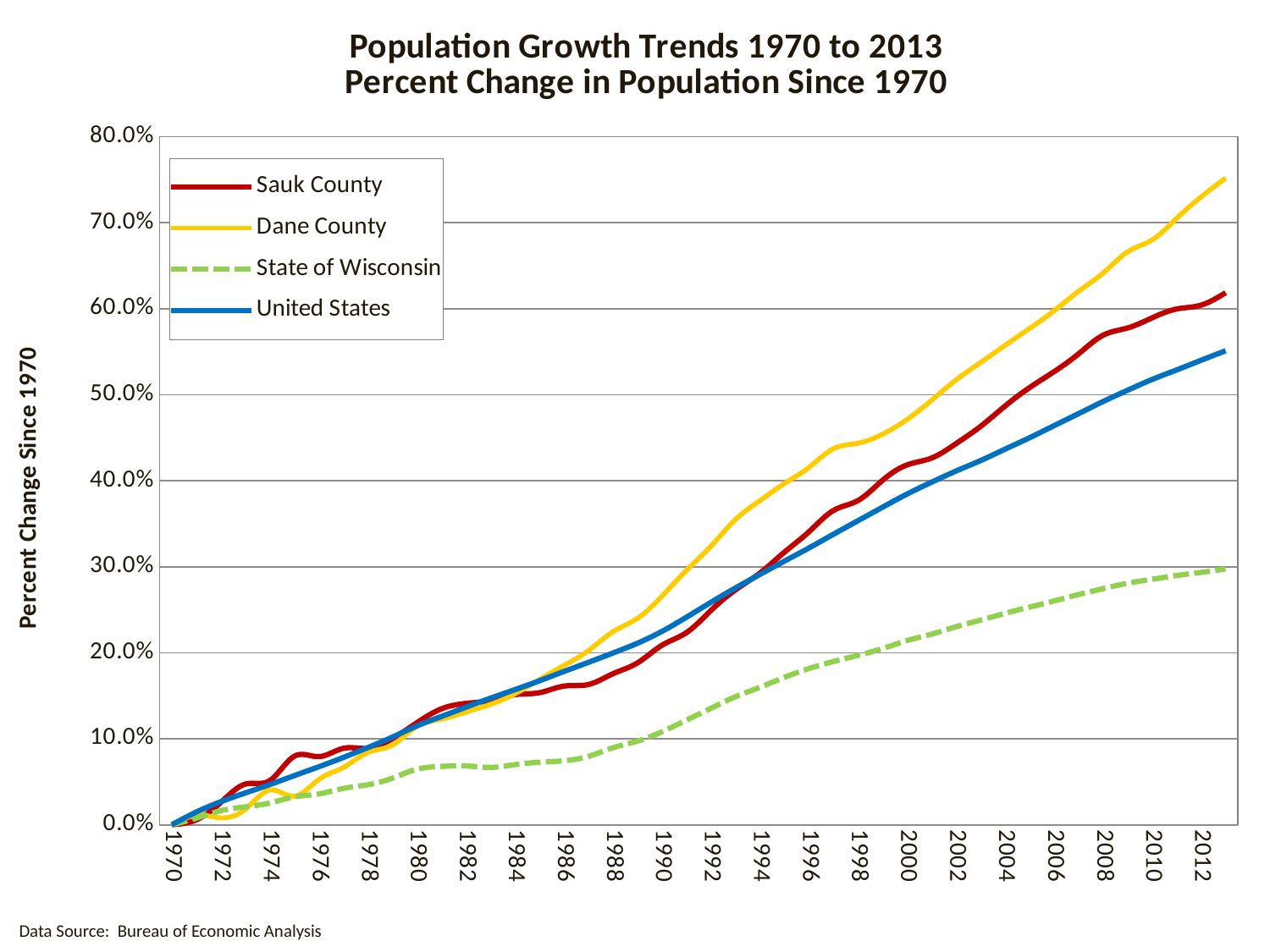
Is the value for Dane County in 2000 greater or less than 40.0%? greater What kind of chart is shown on the slide? Line chart In 2012, which is larger: United States or State of Wisconsin? United States Which series is drawn with a dashed line? State of Wisconsin Is the value for Dane County in 2012 greater or less than 70.0%? greater Is the value for the United States in 2012 greater or less than 50.0%? greater Do the values for Dane County rise or fall from 1970 to 2013? Rise Which series has the lowest percent change at the right end of the chart (2013)? State of Wisconsin At the right end of the chart, which is larger: Dane County or Sauk County? Dane County How many series does the legend list? 4 Which series has the highest percent change at the right end of the chart (2013)? Dane County